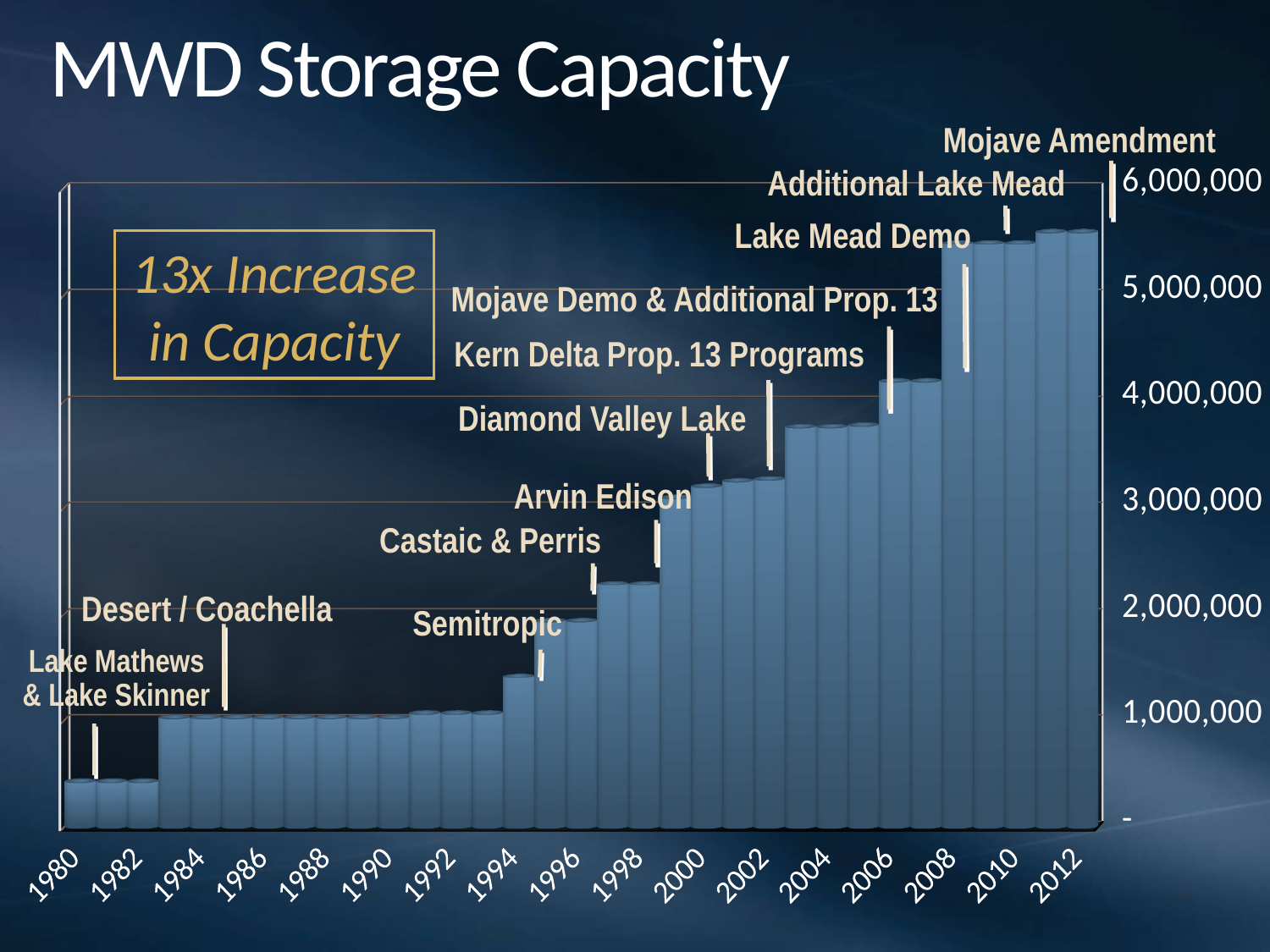
Is the storage capacity value for 1994 greater or less than 2,000,000? less What is the title of the chart? MWD Storage Capacity Is the storage capacity value for 2004 greater or less than 3,000,000? greater Is the storage capacity value for 2012 greater or less than 5,000,000? greater Do the storage capacity values generally rise or fall from 1980 to 2012? rise What kind of chart is shown on the slide? bar chart What does the boxed annotation on the chart say? 13x Increase in Capacity Which year has the larger storage capacity, 1980 or 2012? 2012 Which year has the larger storage capacity, 1994 or 2004? 2004